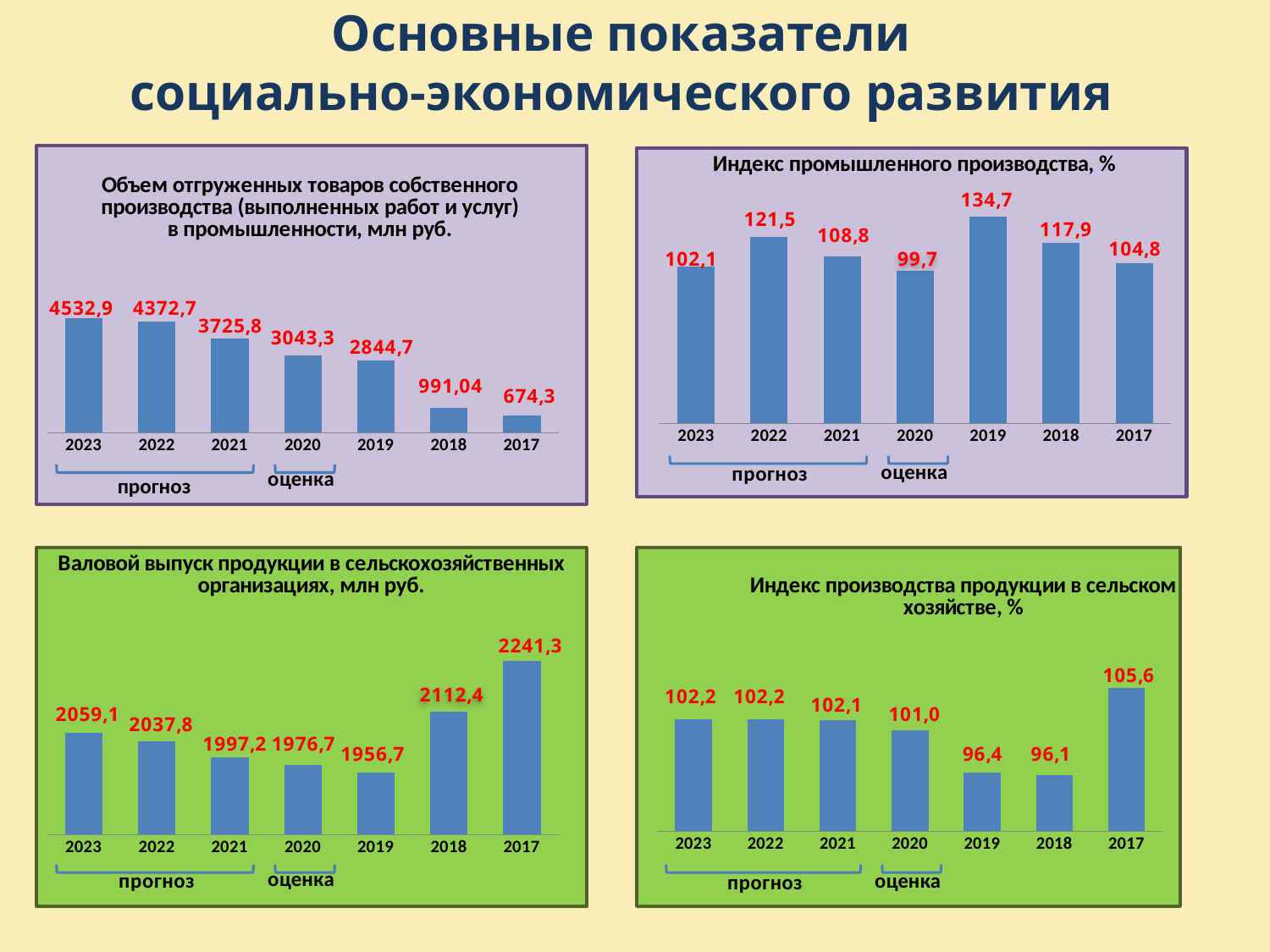
In the top-left chart (Объем отгруженных товаров собственного производства), which year has the lowest value? 2017 In the bottom-right chart (Индекс производства продукции в сельском хозяйстве, %), which is larger: the value for 2019 or the value for 2017? 2017 In the bottom-right chart (Индекс производства продукции в сельском хозяйстве, %), what is the difference between the values for 2017 and 2018? 9,5 In the bottom-left chart (Валовой выпуск продукции в сельскохозяйственных организациях), what is the value for 2018? 2112,4 In the top-right chart (Индекс промышленного производства, %), which year has the highest value? 2019 In the top-left chart (Объем отгруженных товаров собственного производства), what is the value for 2020? 3043,3 In the top-right chart (Индекс промышленного производства, %), what is the difference between the highest value (2019) and the lowest value (2020)? 35,0 In the top-right chart (Индекс промышленного производства, %), what is the value for 2020? 99,7 How many years (categories) are shown in the bottom-right chart (Индекс производства продукции в сельском хозяйстве, %)? 7 What type of chart is the top-left chart (Объем отгруженных товаров собственного производства)? Bar chart In the bottom-left chart (Валовой выпуск продукции в сельскохозяйственных организациях), which year has the highest value? 2017 In the top-left chart (Объем отгруженных товаров собственного производства), what is the difference between the values for 2023 and 2022? 160,2